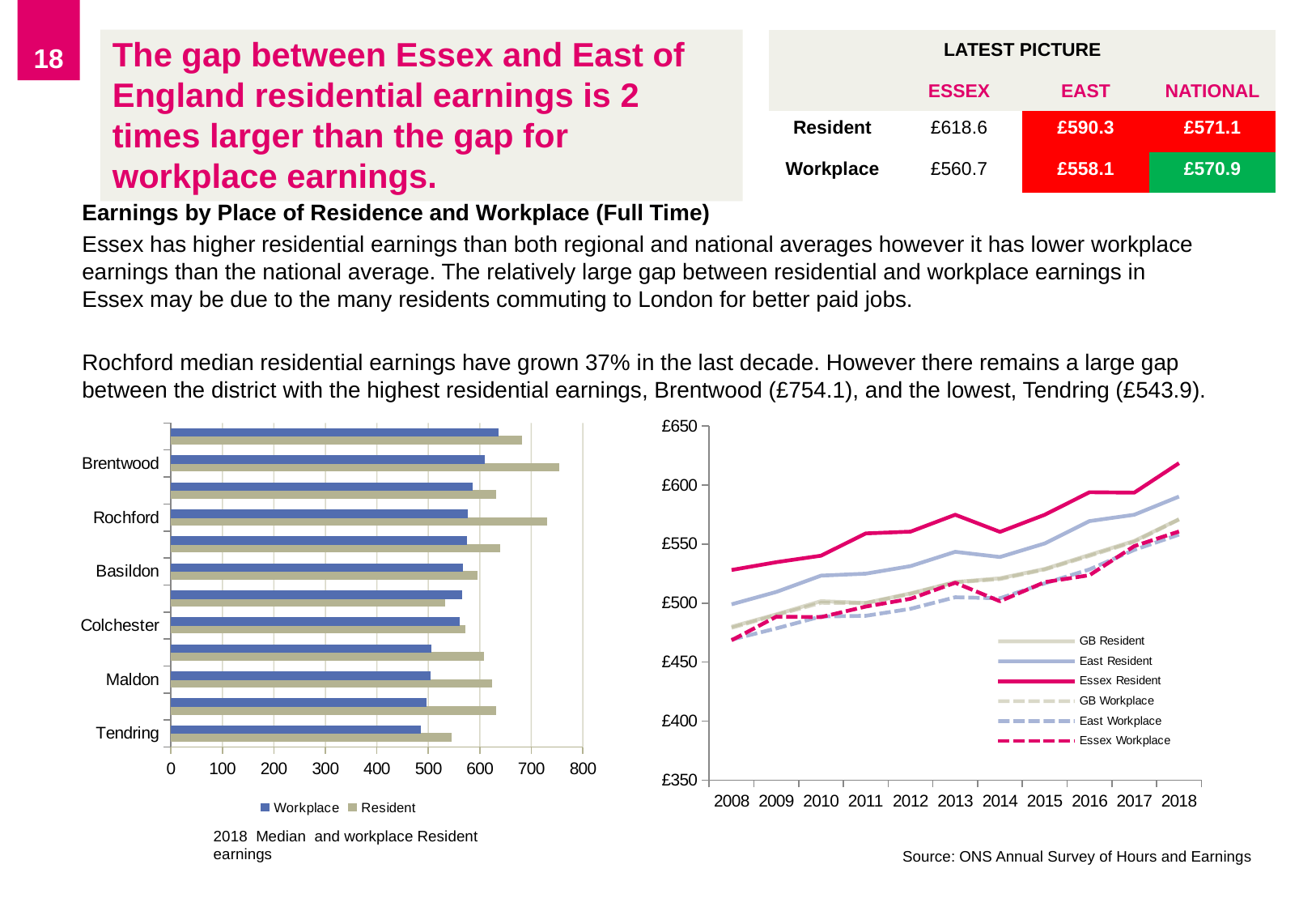
In the bar chart on the left, which is larger for Brentwood, the Workplace value or the Resident value? Resident In the bar chart on the left, is the Resident value for Tendring greater or less than 600? less In the line chart on the right, does the Essex Resident line generally rise or fall from 2008 to 2018? rise In the bar chart on the left, is the Resident value for Brentwood greater or less than 700? greater What kind of chart is the chart on the left of the slide? bar chart What kind of chart is the chart on the right of the slide? line chart In the bar chart on the left, is the Resident value for Rochford greater or less than 700? greater In the line chart on the right, how many years are shown on the x axis? 11 In the line chart on the right, which series has the highest value in 2018? Essex Resident In the line chart on the right, how many series does the legend list? 6 In the bar chart on the left, how many series does the legend list? 2